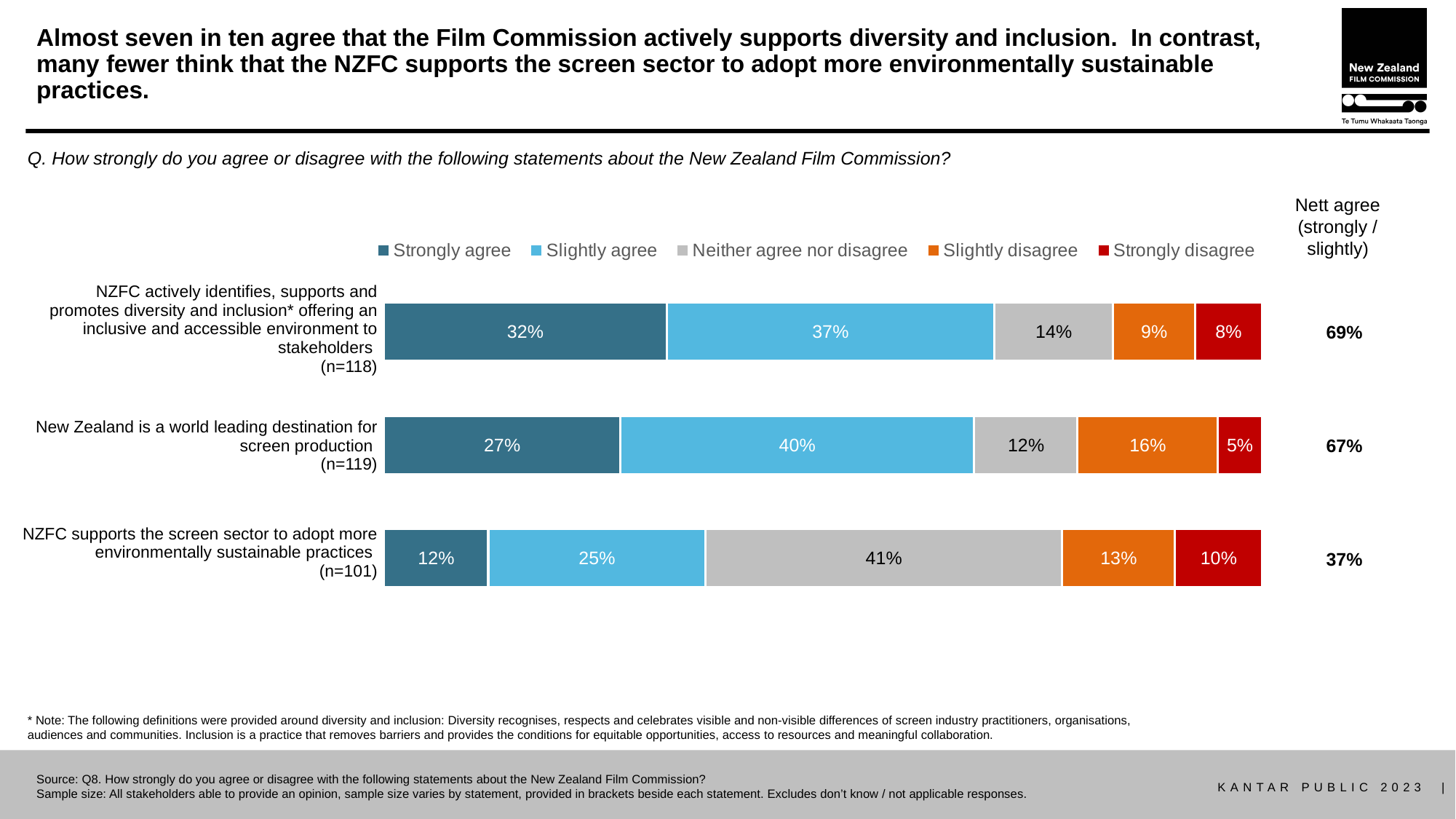
What is the difference between the 'Slightly agree' percentages for 'New Zealand is a world leading destination for screen production' and 'NZFC supports the screen sector to adopt more environmentally sustainable practices'? 15% Which statement has the highest 'Strongly agree' percentage? NZFC actively identifies, supports and promotes diversity and inclusion How many statements are shown in the chart? 3 What colour represents 'Neither agree nor disagree' in the chart? Grey What kind of chart is shown on the slide? Stacked bar chart Which is larger: the 'Strongly disagree' percentage for the diversity and inclusion statement or for the world leading destination statement? Diversity and inclusion statement What percentage strongly agree that NZFC actively identifies, supports and promotes diversity and inclusion? 32% What percentage neither agree nor disagree that NZFC supports the screen sector to adopt more environmentally sustainable practices? 41% How many series does the legend list? 5 What percentage slightly disagree that New Zealand is a world leading destination for screen production? 16% What is the combined 'Strongly agree' and 'Slightly agree' percentage for 'NZFC supports the screen sector to adopt more environmentally sustainable practices'? 37% Which statement has the lowest 'Slightly agree' percentage? NZFC supports the screen sector to adopt more environmentally sustainable practices